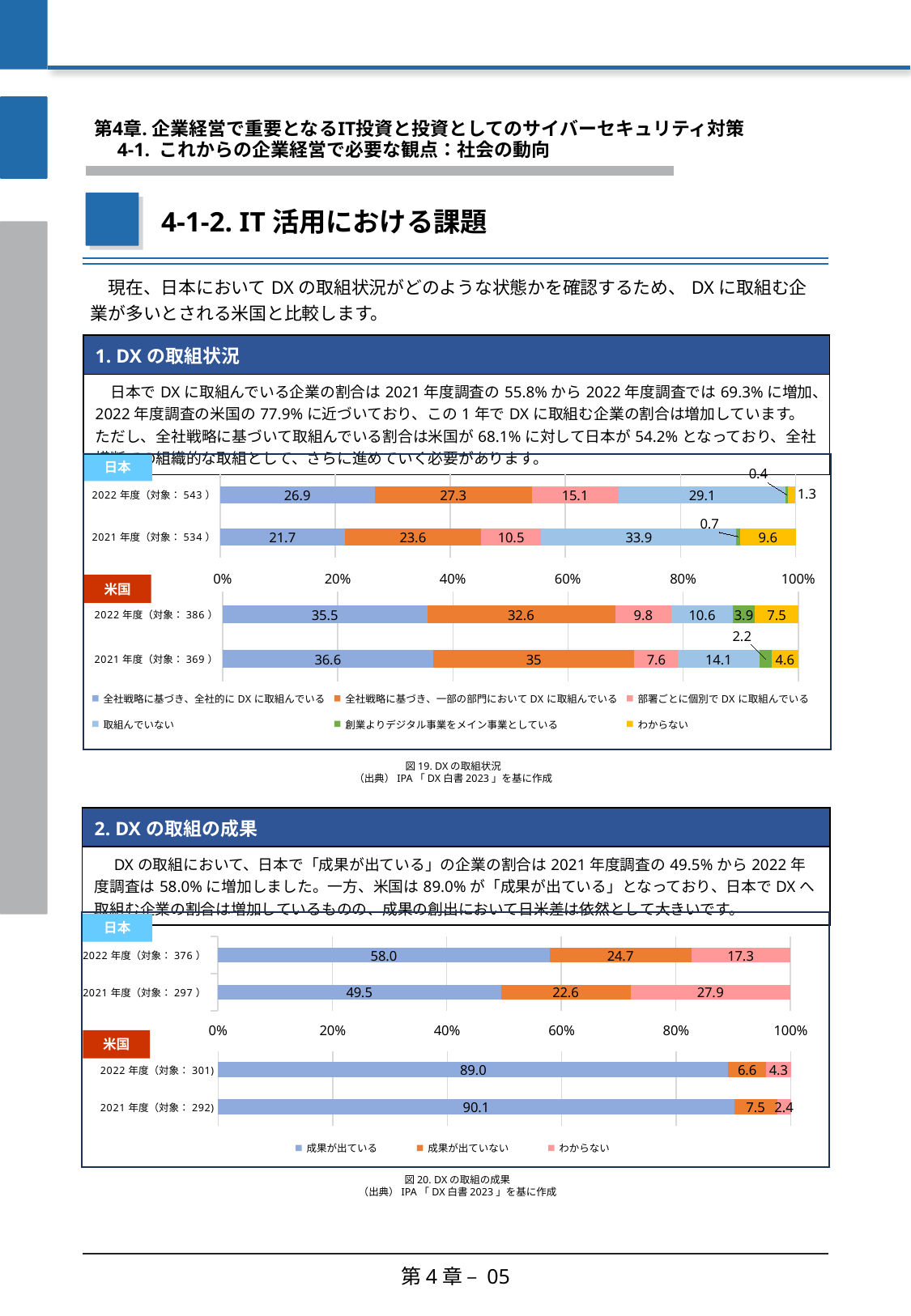
How many series does the legend of the chart 図20 DX の取組の成果 list? 3 In the chart 図20 DX の取組の成果, what is the value for 成果が出ている for 米国 2022 年度? 89.0 In the chart 図19 DX の取組状況, what is the value for 取組んでいない for 米国 2021 年度? 14.1 How many series does the legend of the chart 図19 DX の取組状況 list? 6 In the chart 図20 DX の取組の成果, what is the value for わからない for 日本 2021 年度? 27.9 In the chart 図20 DX の取組の成果, what is the difference between 日本 2022 年度 and 日本 2021 年度 for 成果が出ている? 8.5 In the chart 図19 DX の取組状況, what is the value for 全社戦略に基づき、全社的に DX に取組んでいる for 日本 2022 年度? 26.9 In the chart 図19 DX の取組状況, what is the value for わからない for 日本 2021 年度? 9.6 In the chart 図20 DX の取組の成果, which bar has the highest value for 成果が出ている? 米国 2021 年度 In the chart 図19 DX の取組状況, what is the difference between 米国 2022 年度 and 日本 2022 年度 for 全社戦略に基づき、全社的に DX に取組んでいる? 8.6 What kind of chart is 図20 DX の取組の成果? Stacked horizontal bar chart In the chart 図19 DX の取組状況, which has the larger value for 取組んでいない: 日本 2021 年度 or 米国 2021 年度? 日本 2021 年度